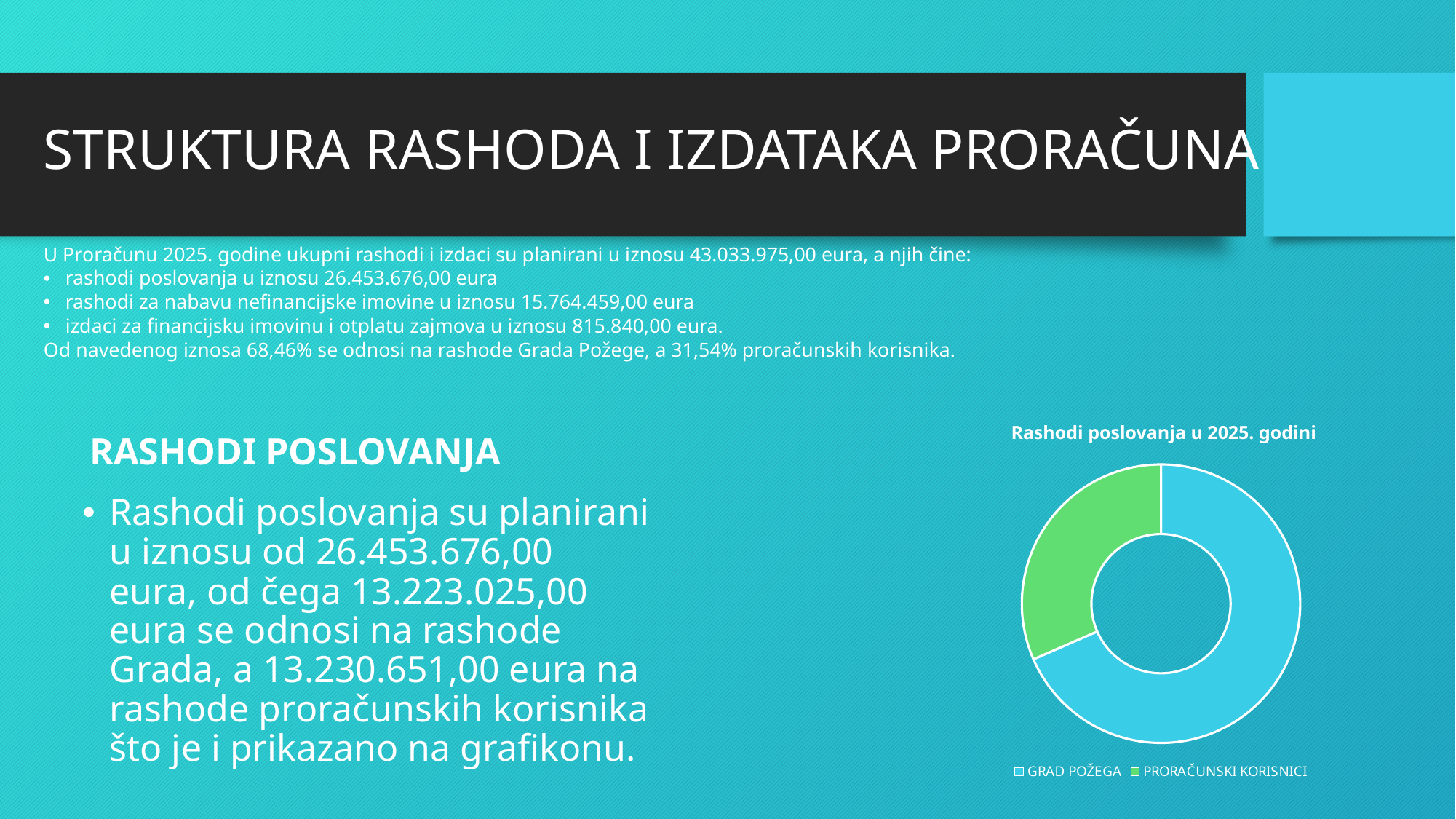
How many categories does the chart's legend list? 2 What is the title of the chart on the slide? Rashodi poslovanja u 2025. godini What colour is the GRAD POŽEGA slice in the chart? Blue What kind of chart is shown on the slide? Doughnut chart Which slice is larger in the chart, GRAD POŽEGA or PRORAČUNSKI KORISNICI? GRAD POŽEGA Which category has the largest slice in the chart? GRAD POŽEGA Which category has the smallest slice in the chart? PRORAČUNSKI KORISNICI